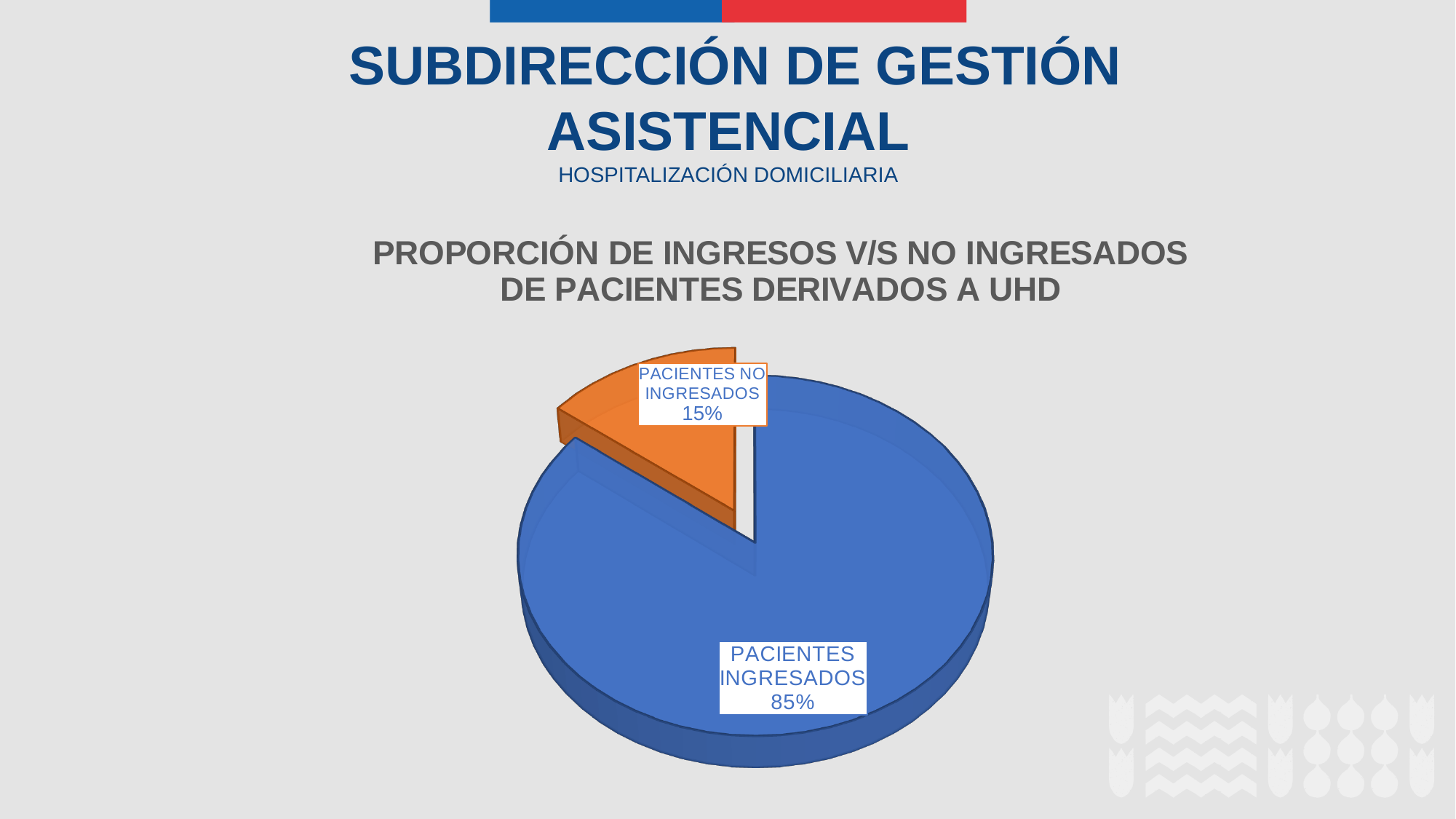
What share of the pie is labelled PACIENTES NO INGRESADOS? 15% How many slices does the pie chart have? 2 What kind of chart is shown on the slide? Pie chart What share of the pie is labelled PACIENTES INGRESADOS? 85% Which is larger, the share for PACIENTES INGRESADOS or for PACIENTES NO INGRESADOS? PACIENTES INGRESADOS What colour is the PACIENTES NO INGRESADOS slice? Orange What is the title of the chart? PROPORCIÓN DE INGRESOS V/S NO INGRESADOS DE PACIENTES DERIVADOS A UHD Which slice of the pie is the largest? PACIENTES INGRESADOS Which slice of the pie is the smallest? PACIENTES NO INGRESADOS What is the difference in percentage points between PACIENTES INGRESADOS and PACIENTES NO INGRESADOS? 70 percentage points